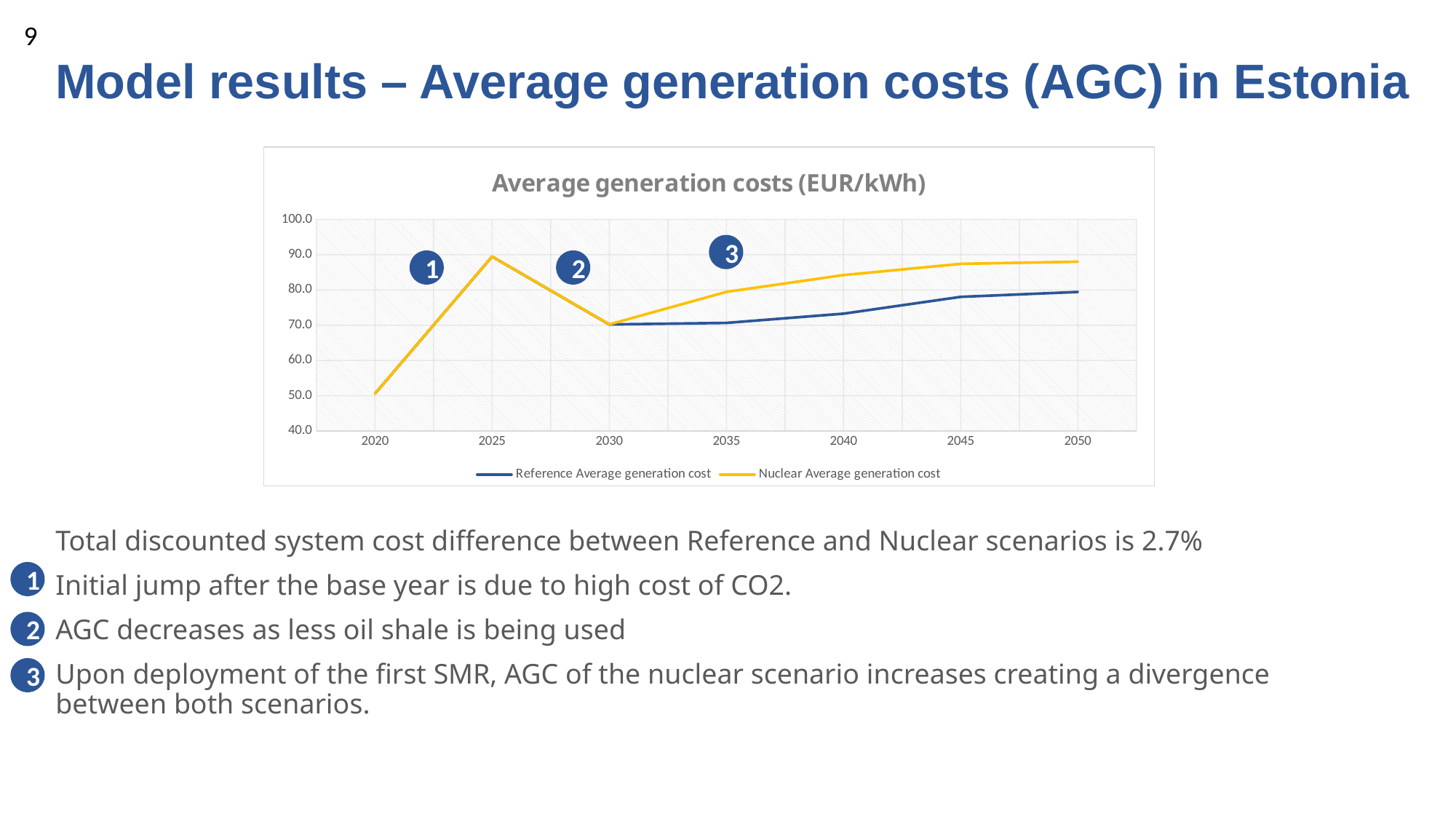
In 2050, which is larger: the Reference Average generation cost or the Nuclear Average generation cost? Nuclear Average generation cost In which year is the Nuclear Average generation cost lowest? 2020 Does the Nuclear Average generation cost rise or fall between 2025 and 2030? fall Is the Reference Average generation cost in 2035 greater or less than 80.0? less What kind of chart is shown on the slide? line chart Which colour is used for the Nuclear Average generation cost line? yellow Is the Nuclear Average generation cost in 2045 greater or less than 80.0? greater Does the Reference Average generation cost rise or fall between 2030 and 2050? rise How many years are marked on the x axis of the chart? 7 How many series does the chart legend list? 2 What is the title of the chart? Average generation costs (EUR/kWh) Is the Nuclear Average generation cost in 2035 greater or less than 70.0? greater